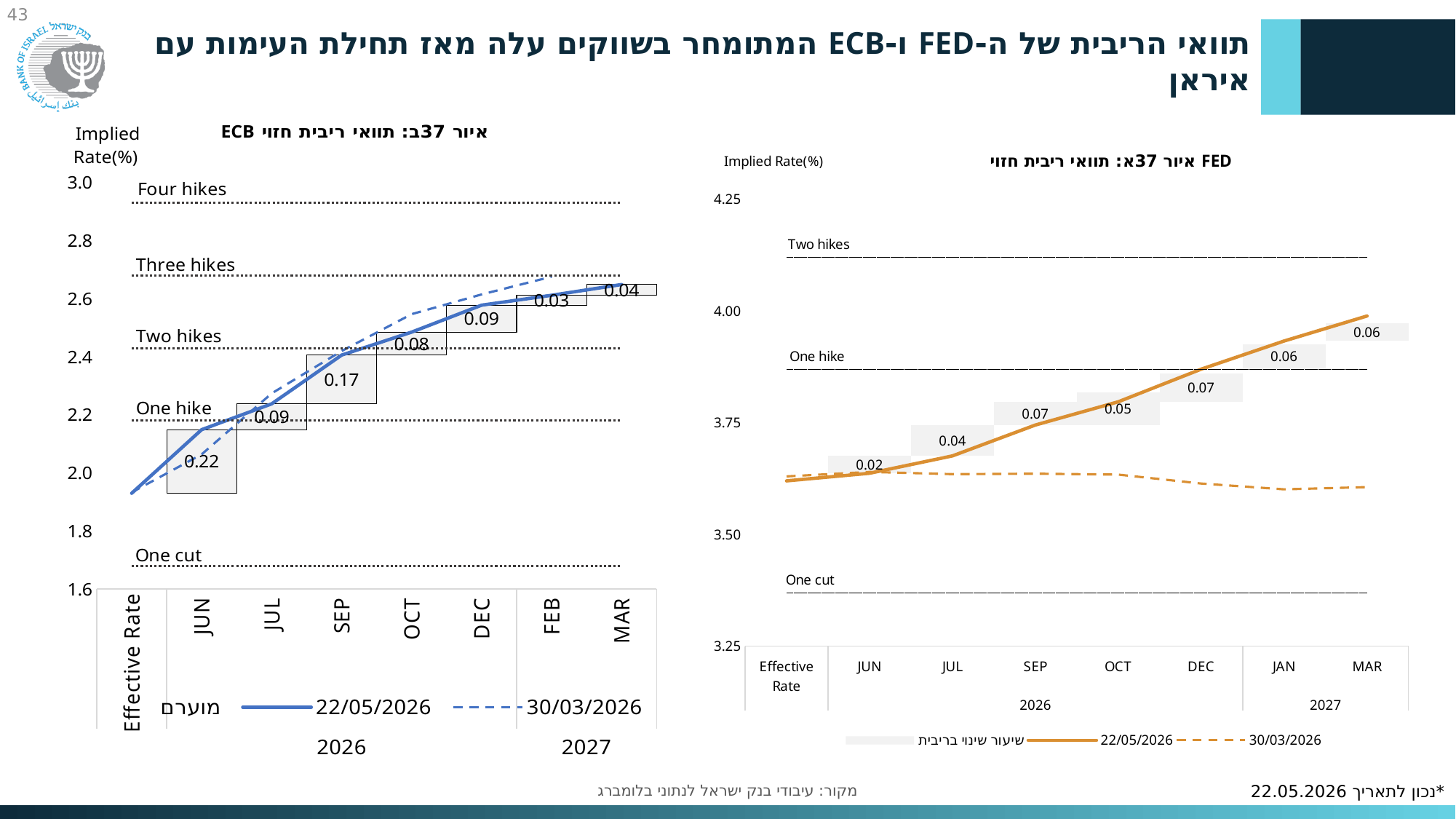
In the ECB chart (איור 37ב), what is the difference between the labelled rate changes for JUN and JUL? 0.13 In the FED chart (איור 37א), does the 22/05/2026 line rise or fall from JUN 2026 to MAR 2027? rise In the FED chart (איור 37א), which month has the smallest labelled rate change? JUN In the ECB chart (איור 37ב), what is the labelled rate change for JUN? 0.22 In the FED chart (איור 37א), what is the labelled rate change for OCT? 0.05 In the FED chart (איור 37א), is the labelled rate change for SEP larger or smaller than that for OCT? larger In the FED chart (איור 37א), is the Effective Rate value of the 22/05/2026 line greater or less than 3.75? less In the ECB chart (איור 37ב), which month has the largest labelled rate change? JUN What kind of chart is the ECB chart (איור 37ב)? combination line and bar chart In the FED chart (איור 37א), what is the labelled rate change for JUL? 0.04 In the ECB chart (איור 37ב), what is the labelled rate change for SEP? 0.17 In the ECB chart (איור 37ב), which month has the smallest labelled rate change? FEB